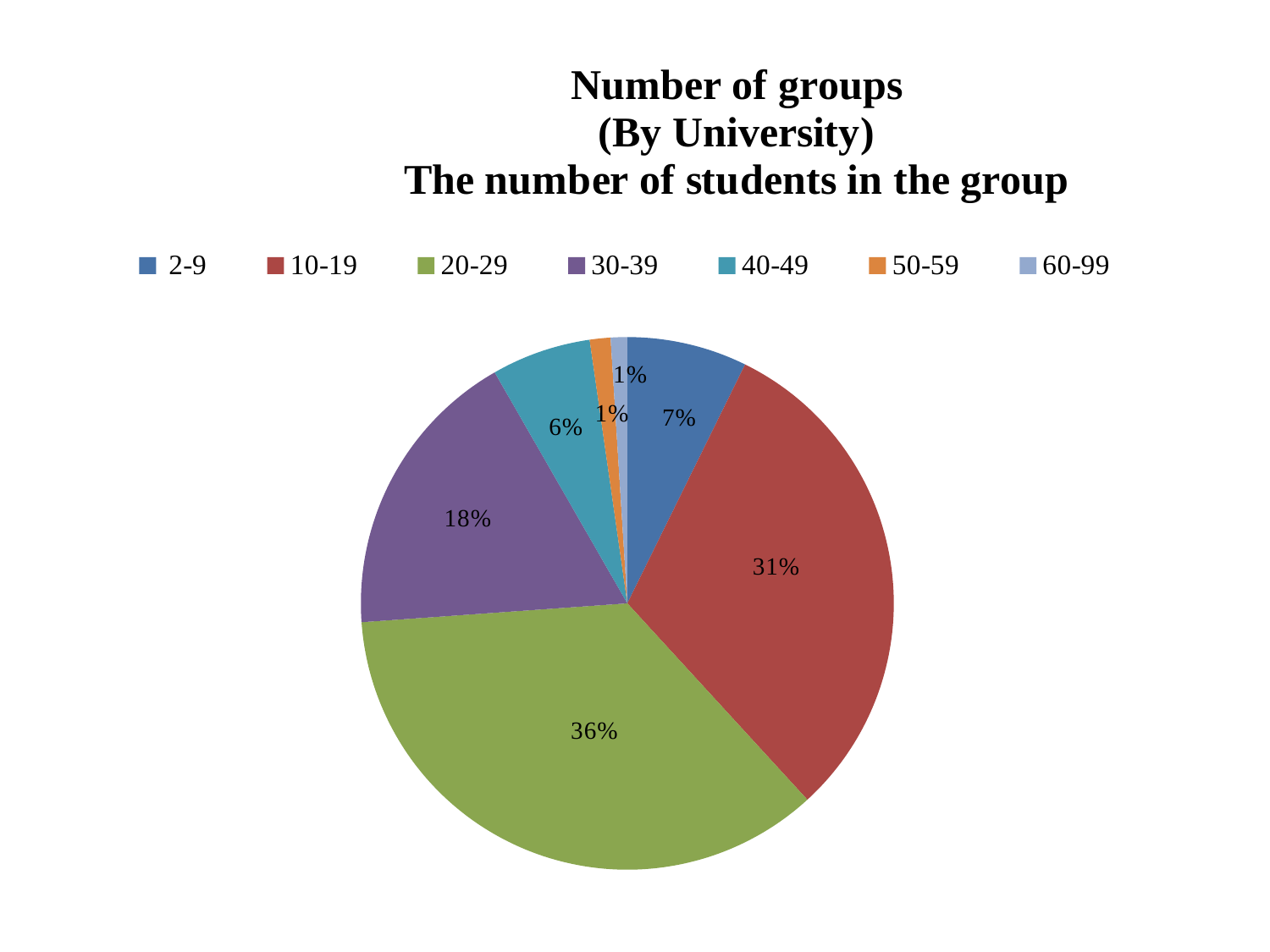
How many categories does the legend list? 7 What share of the pie does the 10-19 category have? 31% What is the title of the chart? Number of groups (By University) The number of students in the group What is the difference between the 30-39 and 2-9 shares? 11% What share of the pie does the 30-39 category have? 18% What is the difference between the 20-29 and 10-19 shares? 5% What type of chart is shown on the slide? pie chart What share of the pie does the 20-29 category have? 36% Which is larger, the share for 30-39 or the share for 40-49? 30-39 Which category has the largest slice of the pie? 20-29 What is the value shown for the 40-49 category? 6% What is the value shown for the 2-9 category? 7%